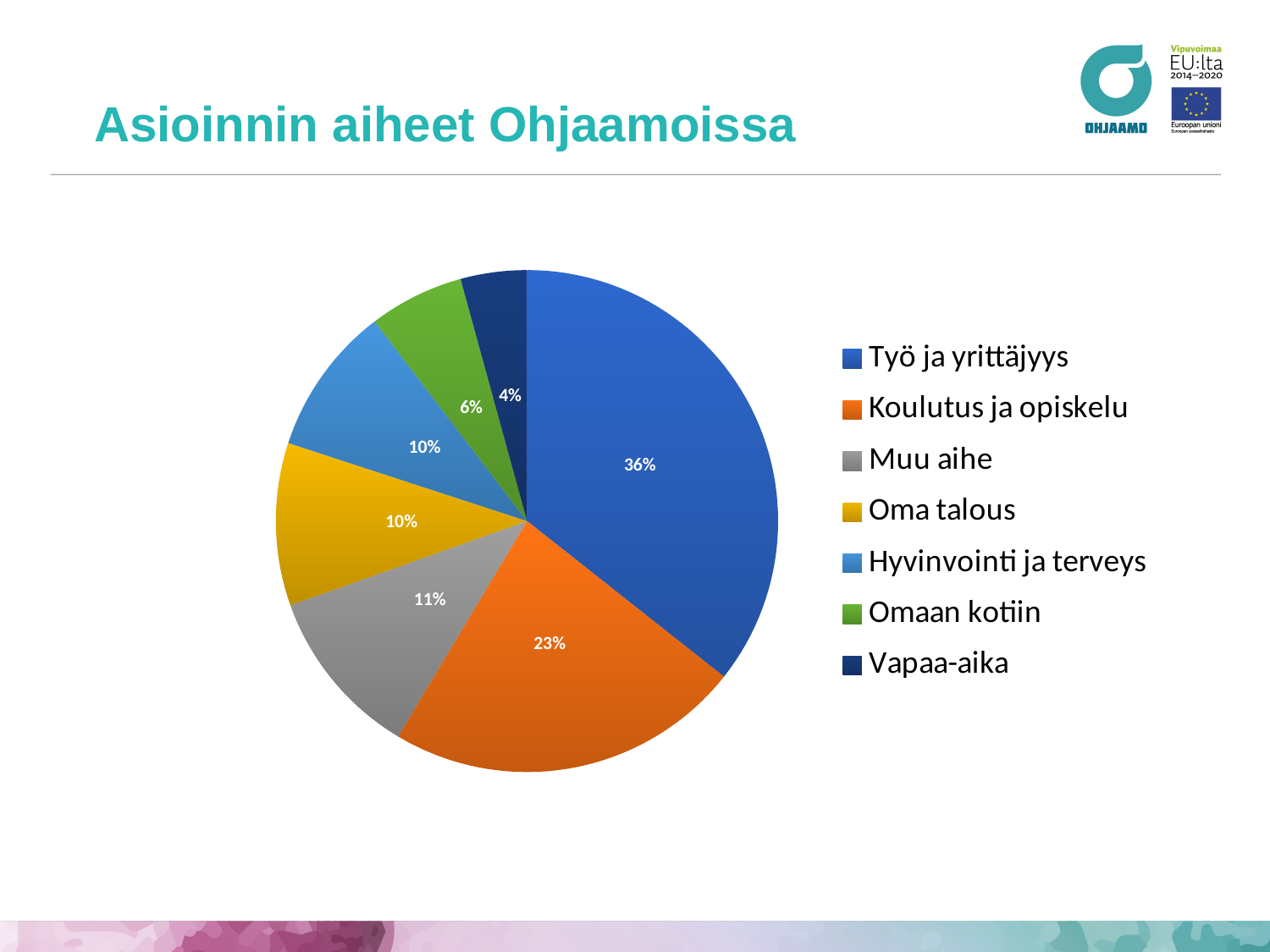
How many categories does the pie chart have? 7 What colour is the slice for Oma talous? Yellow What is the value for Koulutus ja opiskelu? 23% What share of the pie does Työ ja yrittäjyys have? 36% What kind of chart is shown on the slide? Pie chart Which category has the largest slice of the pie? Työ ja yrittäjyys What is the value for Omaan kotiin? 6% What is the title of the slide containing the pie chart? Asioinnin aiheet Ohjaamoissa Which is larger, the share for Muu aihe or the share for Omaan kotiin? Muu aihe What is the difference between the shares of Työ ja yrittäjyys and Koulutus ja opiskelu? 13 percentage points Which category has the smallest slice of the pie? Vapaa-aika What is the value for Muu aihe? 11%